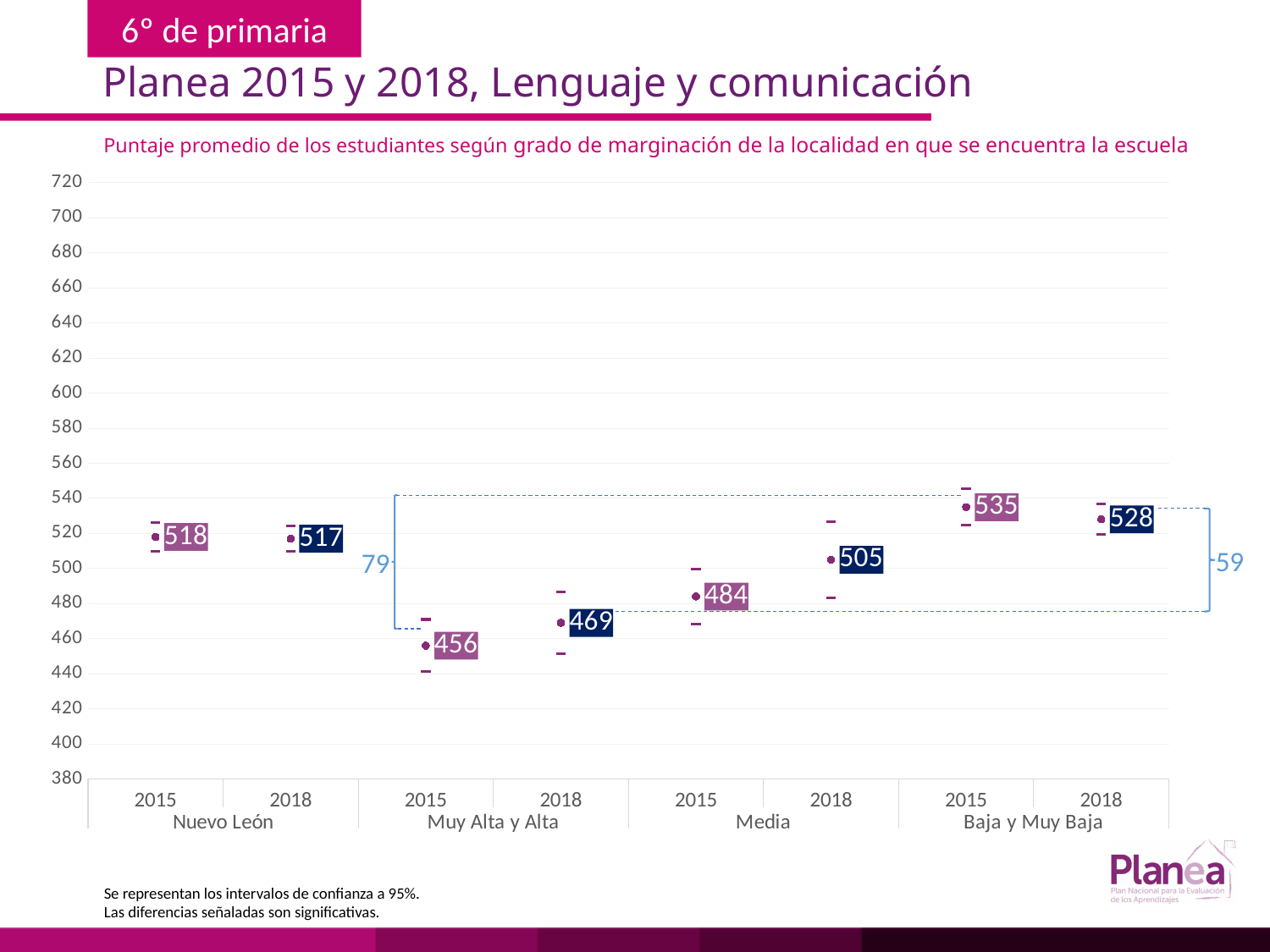
What is the 2015 average score for Muy Alta y Alta? 456 Which group and year has the highest average score? Baja y Muy Baja, 2015 (535) From 2015 to 2018, did the score for Muy Alta y Alta rise or fall? rise Is the 2015 score for Baja y Muy Baja greater or less than 520? greater Which is larger, the 2015 score for Media or the 2018 score for Media? 2018 (505) Which group and year has the lowest average score? Muy Alta y Alta, 2015 (456) What is the difference between the 2018 scores of Media and Muy Alta y Alta? 36 What is the difference between the 2015 scores of Baja y Muy Baja and Muy Alta y Alta? 79 What is the 2018 average score for Media? 505 What is the 2018 average score for Nuevo León? 517 How many marginalization groups are shown on the x axis? 4 What is the difference annotated between the 2018 scores of Baja y Muy Baja and Muy Alta y Alta? 59